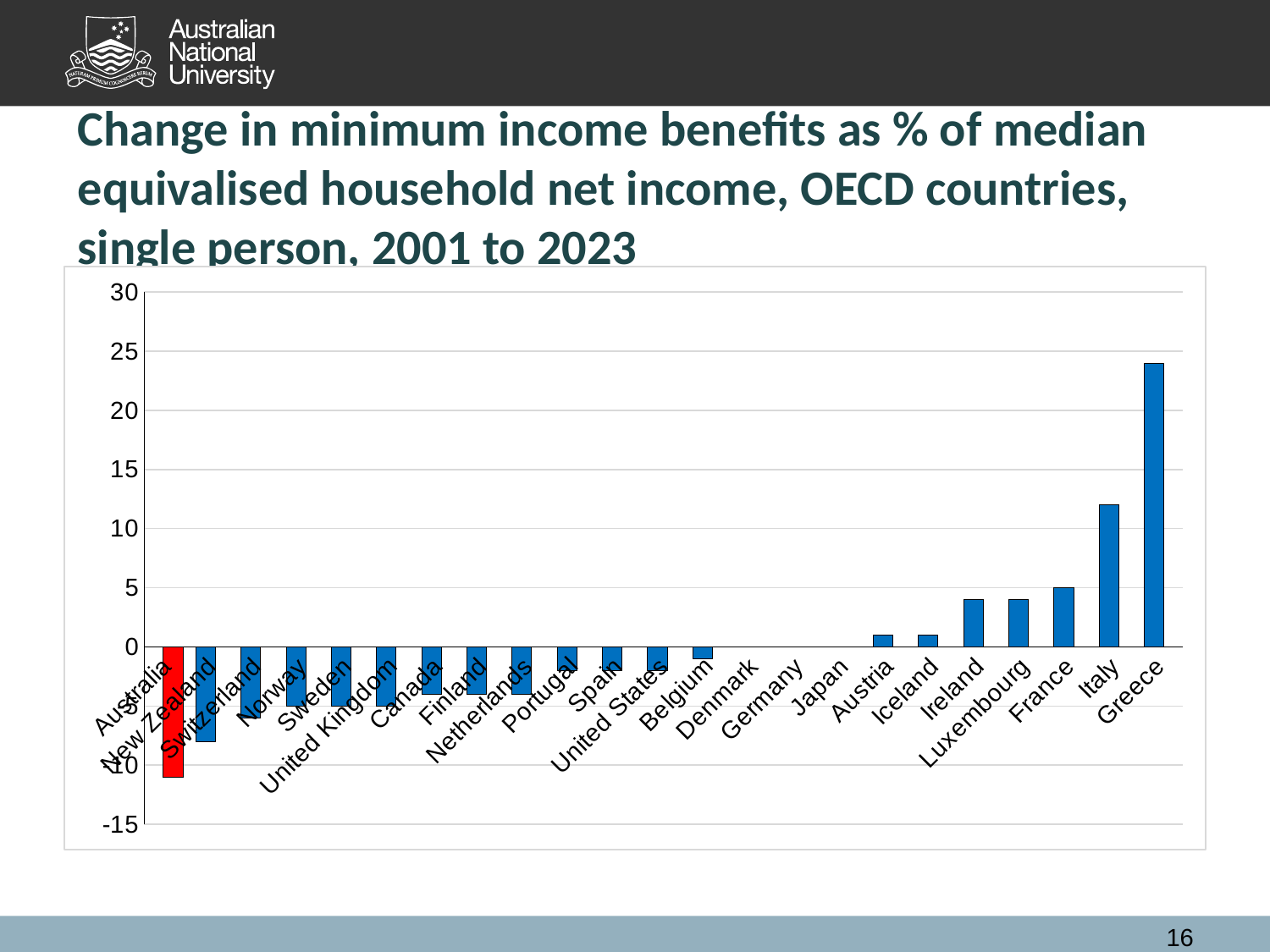
Is the value for Italy greater or less than 10? greater Is the value for New Zealand greater or less than -5? less Which country's bar is coloured red in the chart? Australia How many countries are shown on the x axis of the chart? 23 Is the value for Ireland greater or less than 5? less Which country has the lowest value in the chart? Australia What kind of chart is shown on the slide? bar chart Which country has the highest value in the chart? Greece Which has the larger value, Greece or Italy? Greece Which has the larger value, Australia or New Zealand? New Zealand